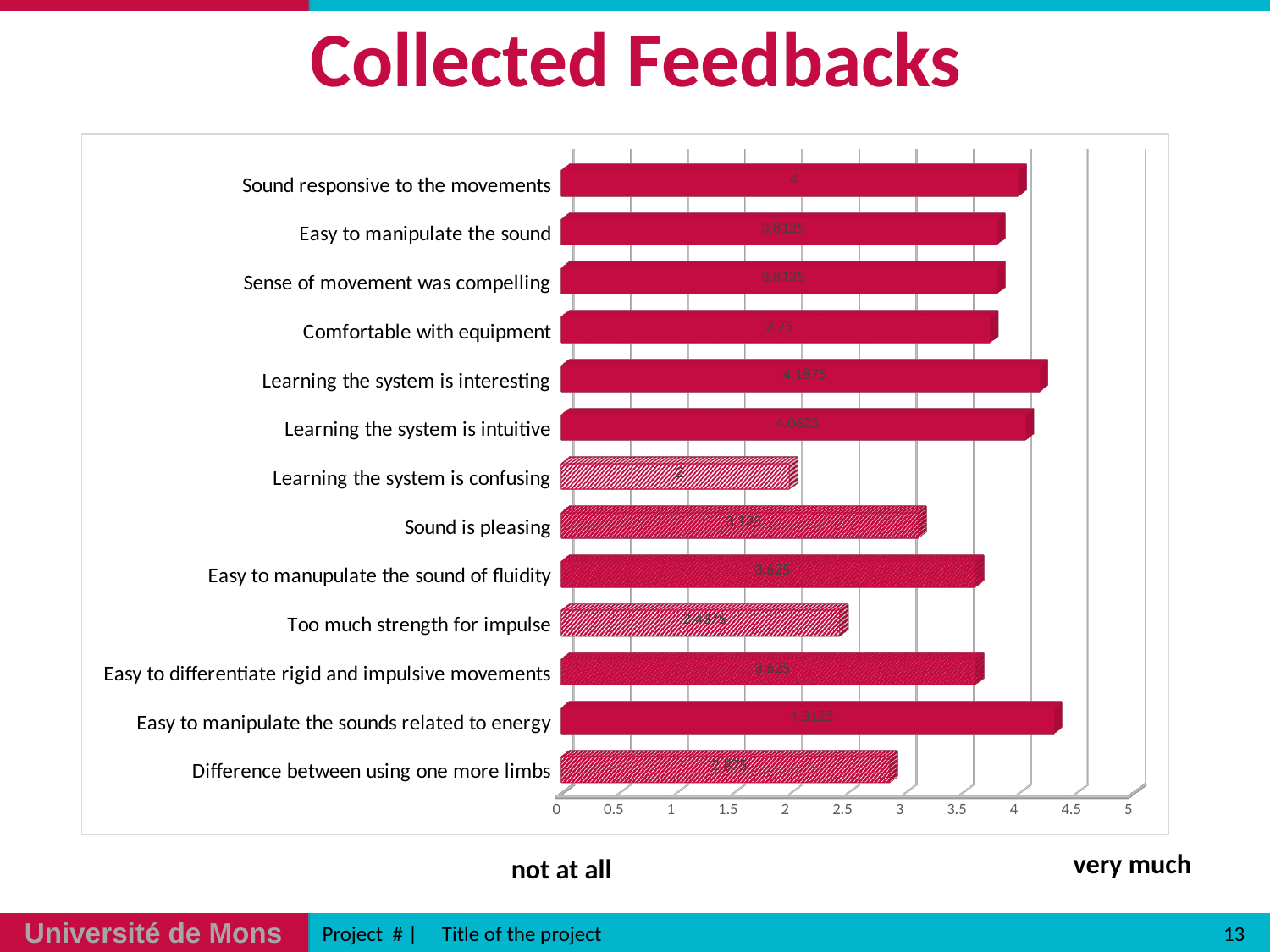
Which category has the lowest value? Learning the system is confusing Which category has the highest value? Easy to manipulate the sounds related to energy What is the difference between the values for "Learning the system is intuitive" and "Learning the system is confusing"? 2.0625 Is the value for "Easy to manupulate the sound of fluidity" greater or less than 3? greater Which is larger, the value for "Sound is pleasing" or the value for "Difference between using one more limbs"? Sound is pleasing What is the value for "Comfortable with equipment"? 3.75 What is the title of the chart on the slide? Collected Feedbacks What type of chart is shown on the slide? bar chart What is the value for "Too much strength for impulse"? 2.4375 What is the value for "Sound responsive to the movements"? 4 How many categories are plotted in the chart? 13 What is the value for "Learning the system is interesting"? 4.1875